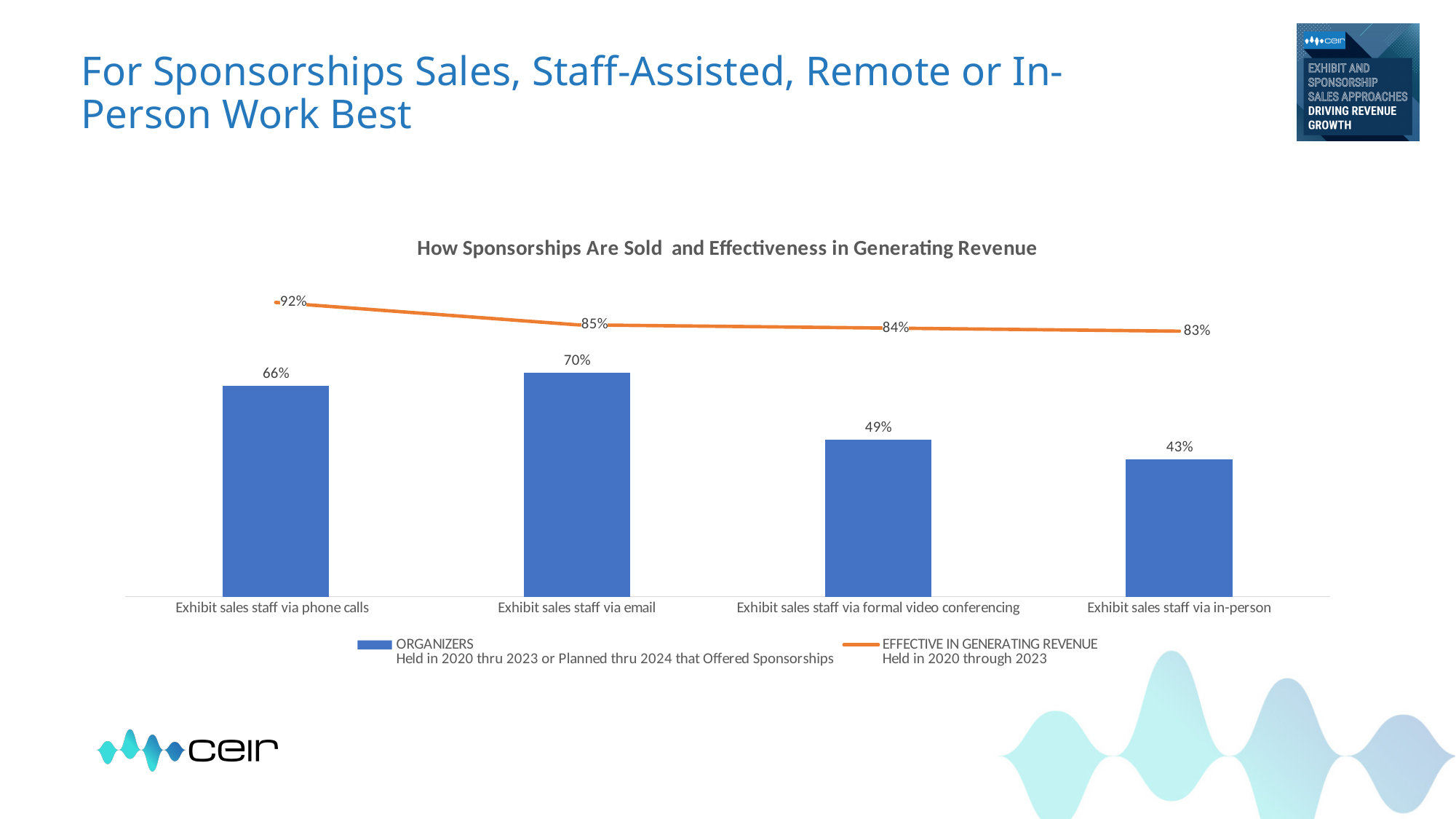
Which sales method has the highest Organizers percentage? Exhibit sales staff via email What kind of chart is used for the Organizers series? Bar chart What is the 'Effective in Generating Revenue' value for exhibit sales staff via phone calls? 92% What is the difference between the Organizers values for exhibit sales staff via email and via formal video conferencing? 21 percentage points What is the Organizers value for exhibit sales staff via in-person? 43% Which is larger: the Organizers value for phone calls or for in-person? Phone calls Does the 'Effective in Generating Revenue' line rise or fall from left to right across the categories? Fall How many sales methods (categories) are shown on the x axis? 4 Which sales method has the lowest 'Effective in Generating Revenue' percentage? Exhibit sales staff via in-person How many series does the legend list? 2 What percentage of organizers sell sponsorships via exhibit sales staff via email? 70% What is the title of the chart? How Sponsorships Are Sold and Effectiveness in Generating Revenue